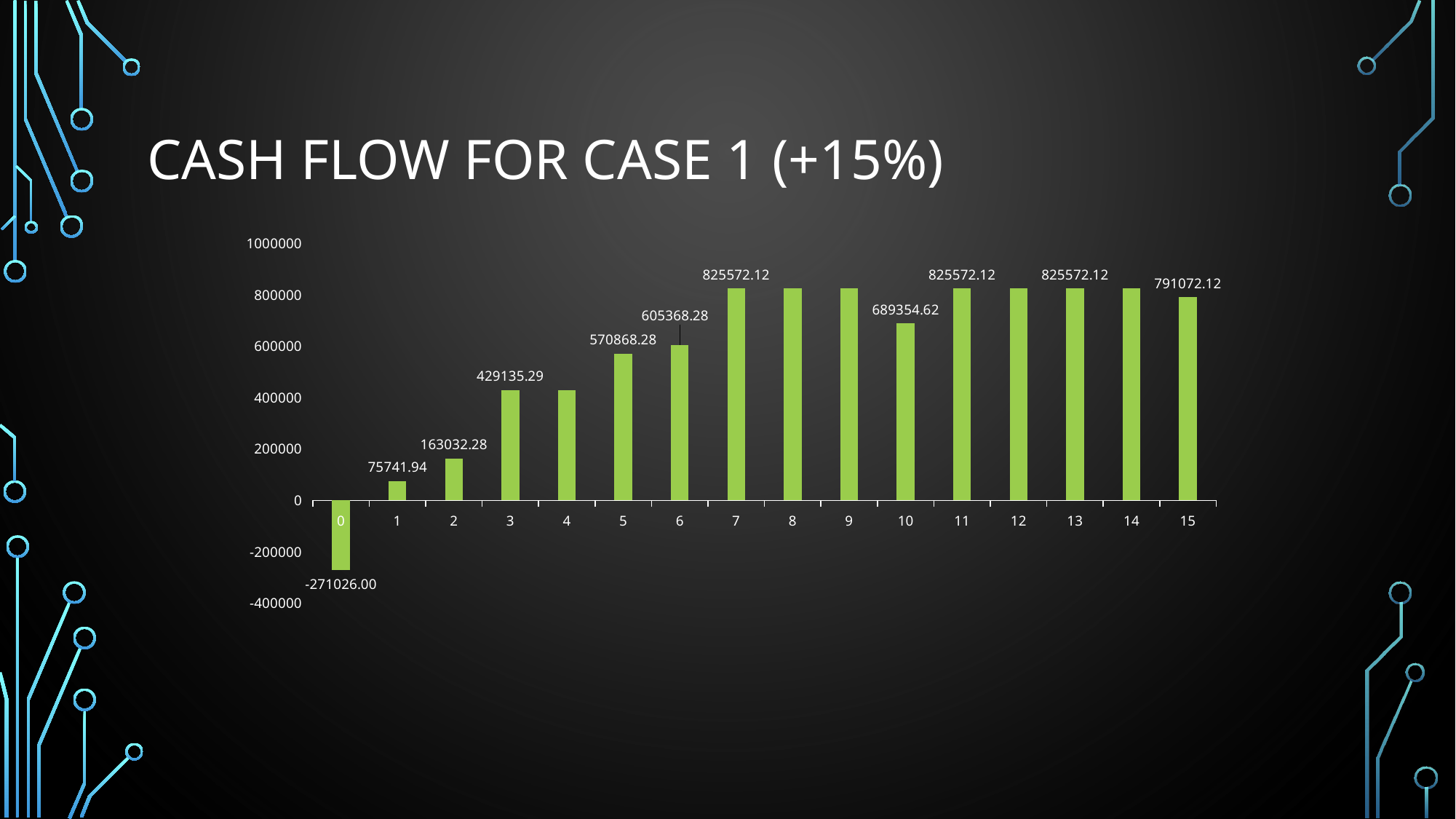
What kind of chart is shown on the slide? bar chart What is the difference between the values for year 6 and year 5? 34500.00 Is the value for year 8 greater or less than 800000? greater Which year has the lowest cash flow value? 0 What is the cash flow value for year 10? 689354.62 How many bars (years) are plotted on the chart? 16 Which has the larger value, year 10 or year 11? 11 What is the cash flow value for year 3? 429135.29 What is the cash flow value for year 0? -271026.00 What is the title of the chart on the slide? CASH FLOW FOR CASE 1 (+15%) Is the value for year 4 greater or less than 400000? greater What is the cash flow value for year 15? 791072.12